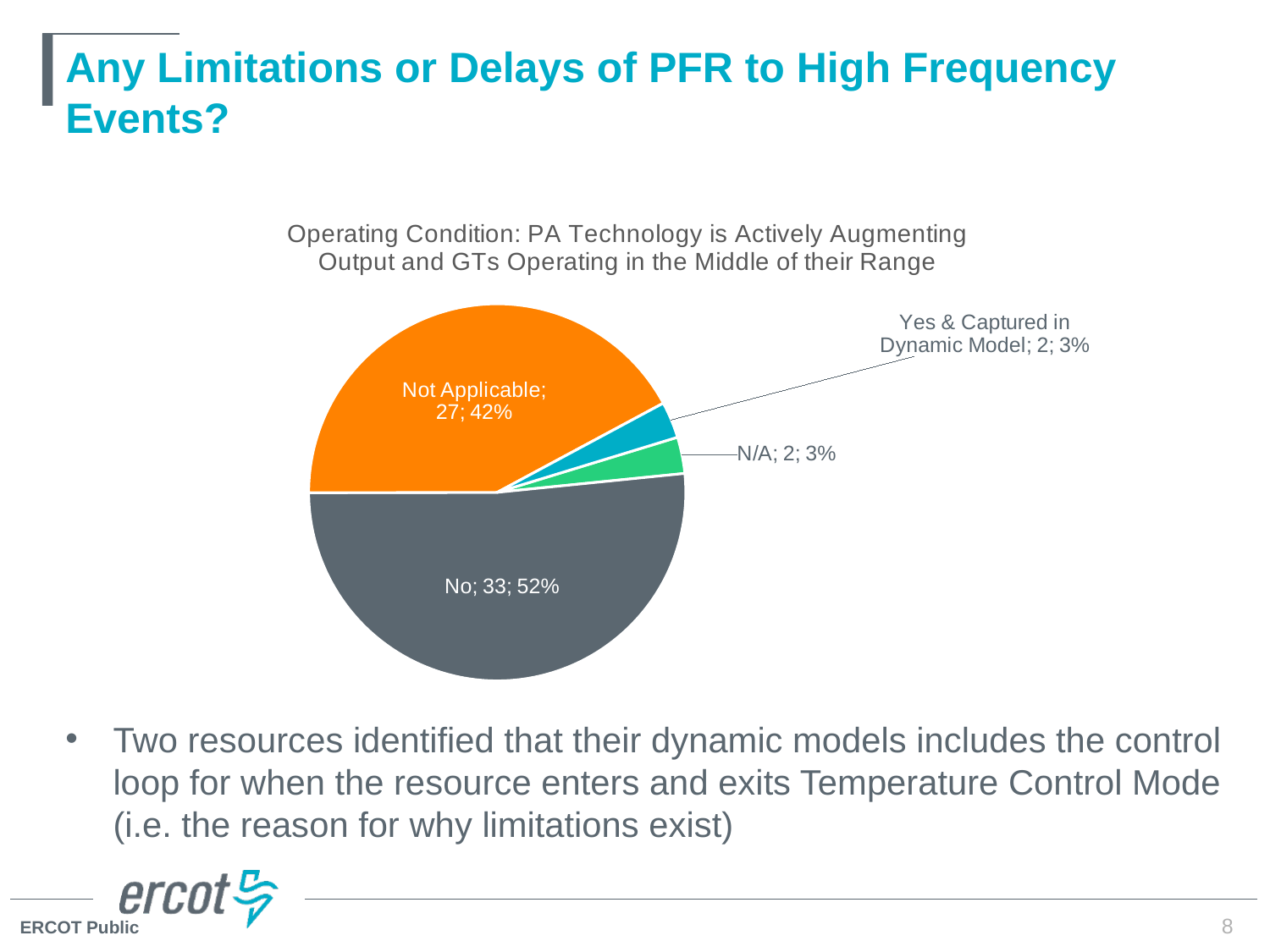
What kind of chart is shown on the slide? pie chart Which is larger, the "Not Applicable" slice or the "N/A" slice? Not Applicable What percentage share does the "No" slice represent? 52% What percentage share does the "Not Applicable" slice represent? 42% What is the difference in count between the "No" and "Not Applicable" slices? 6 What is the count for the "No" slice? 33 What is the count for the "Yes & Captured in Dynamic Model" slice? 2 What is the total count across all slices of the pie chart? 64 Which category has the largest slice of the pie? No What colour is the "Not Applicable" slice? orange What is the title of the pie chart? Operating Condition: PA Technology is Actively Augmenting Output and GTs Operating in the Middle of their Range How many slices does the pie chart have? 4